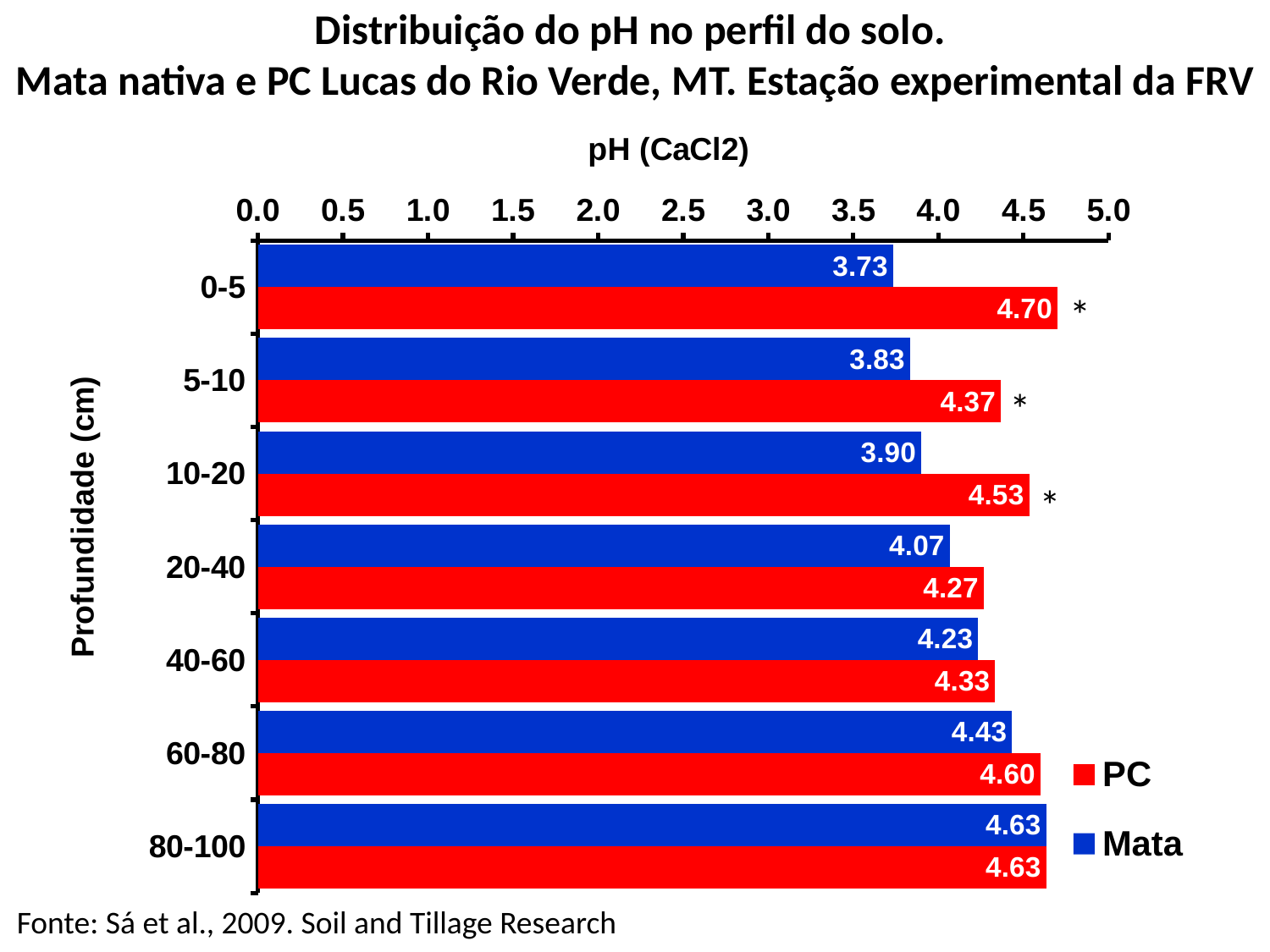
Do the Mata pH values rise or fall as depth increases from 0-5 to 80-100 cm? Rise What kind of chart is shown on the slide? Bar chart At which depth is the PC pH value highest? 0-5 What is the difference between the PC and Mata pH values at the 0-5 cm depth? 0.97 Which colour represents the PC series in the legend? Red What is the pH value for Mata at the 0-5 cm depth? 3.73 Which is larger at the 5-10 cm depth, the PC value or the Mata value? PC At which depth is the Mata pH value lowest? 0-5 What is the pH value for PC at the 10-20 cm depth? 4.53 How many series does the legend list? 2 What is the pH value for PC at the 60-80 cm depth? 4.60 How many depth categories are shown on the chart? 7